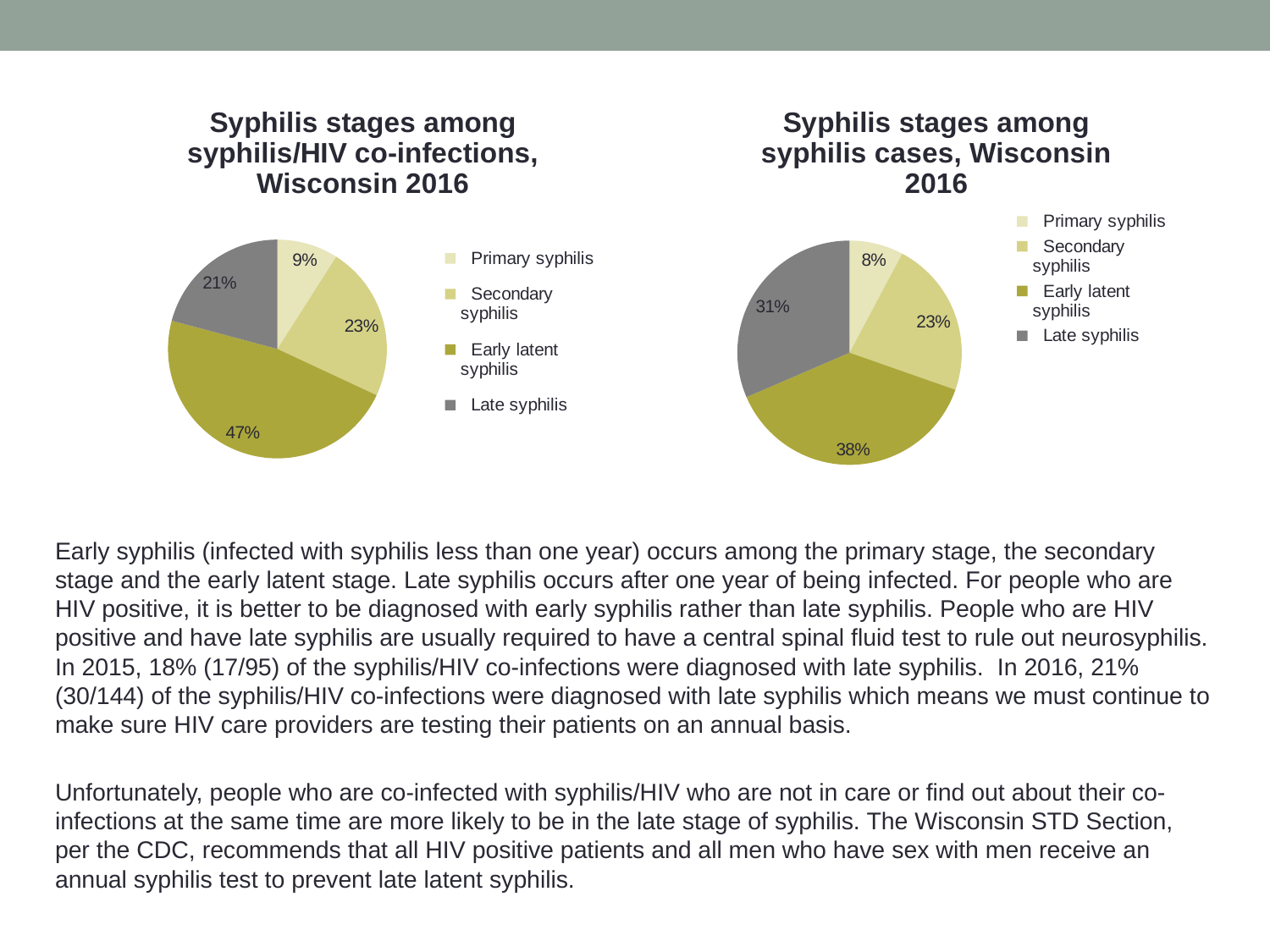
In the chart 'Syphilis stages among syphilis cases, Wisconsin 2016', which stage has the smallest slice? Primary syphilis In the chart 'Syphilis stages among syphilis/HIV co-infections, Wisconsin 2016', what percentage is shown for Late syphilis? 21% In the chart 'Syphilis stages among syphilis cases, Wisconsin 2016', what share of the pie is Late syphilis? 31% How many entries does the legend of the chart 'Syphilis stages among syphilis cases, Wisconsin 2016' list? 4 How many slices does the pie in the chart 'Syphilis stages among syphilis cases, Wisconsin 2016' have? 4 What type of chart is used in 'Syphilis stages among syphilis/HIV co-infections, Wisconsin 2016'? Pie chart Which chart shows a larger share for Late syphilis: the left chart (syphilis/HIV co-infections) or the right chart (all syphilis cases)? The right chart (syphilis cases) In the chart 'Syphilis stages among syphilis/HIV co-infections, Wisconsin 2016', what percentage is shown for Primary syphilis? 9% In the chart 'Syphilis stages among syphilis/HIV co-infections, Wisconsin 2016', which stage has the largest slice? Early latent syphilis In the chart 'Syphilis stages among syphilis/HIV co-infections, Wisconsin 2016', what is the difference between the Early latent syphilis and Late syphilis percentages? 26% In the chart 'Syphilis stages among syphilis cases, Wisconsin 2016', what percentage is shown for Early latent syphilis? 38% In the chart 'Syphilis stages among syphilis/HIV co-infections, Wisconsin 2016', what share of the pie is Early latent syphilis? 47%